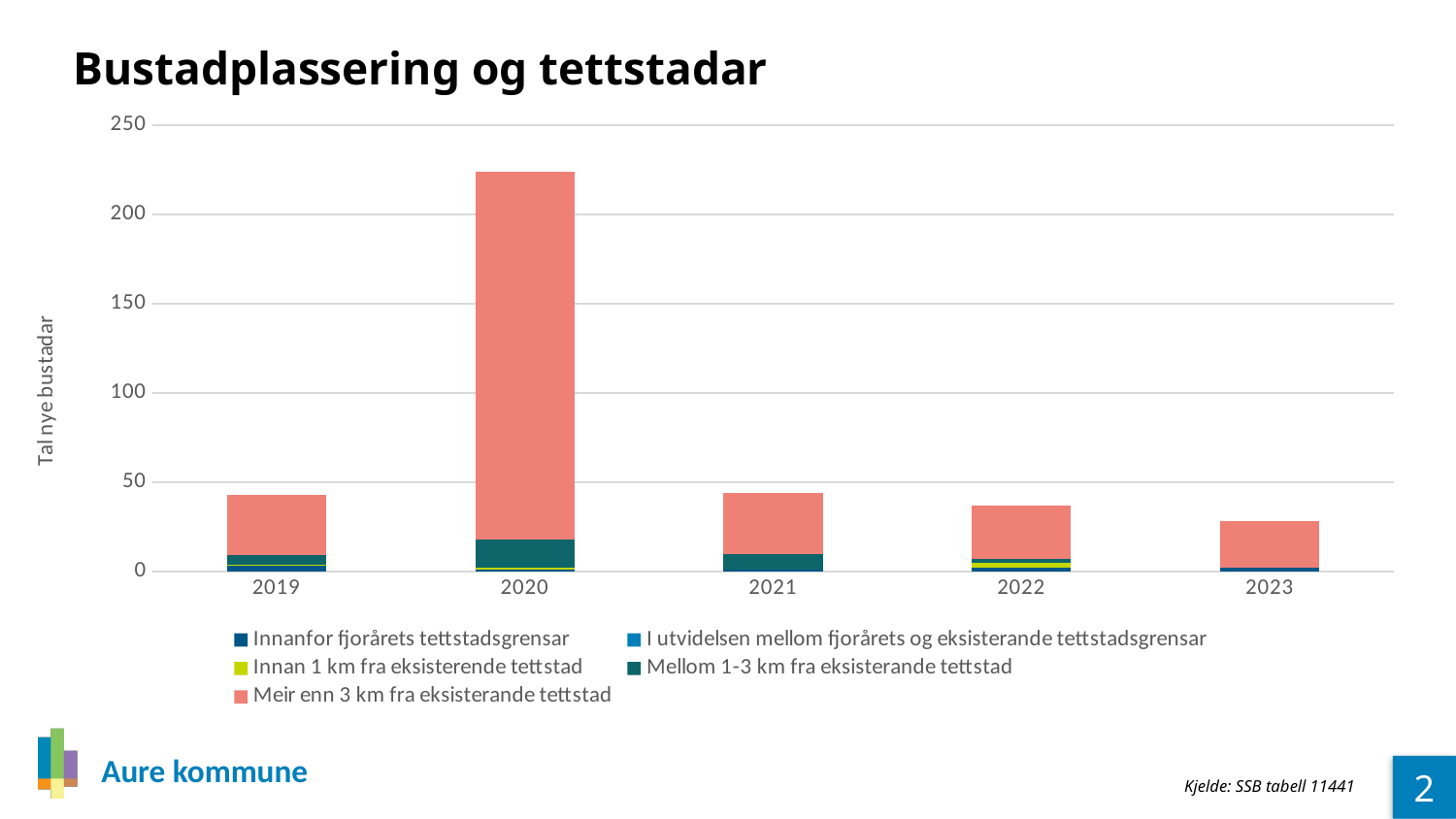
Is the total value for 2020 greater or less than 200? greater Which year has the shortest stacked bar? 2023 Is the total value for 2019 greater or less than 50? less How many years are shown on the x axis of the chart? 5 What is the label on the y axis of the chart? Tal nye bustadar What is the title of the chart? Bustadplassering og tettstadar Which year has a larger total, 2020 or 2021? 2020 Is the total value for 2023 greater or less than 50? less How many series does the legend list? 5 Which year has the tallest stacked bar? 2020 What kind of chart is shown on the slide? Stacked bar chart Which year has a larger total, 2022 or 2023? 2022